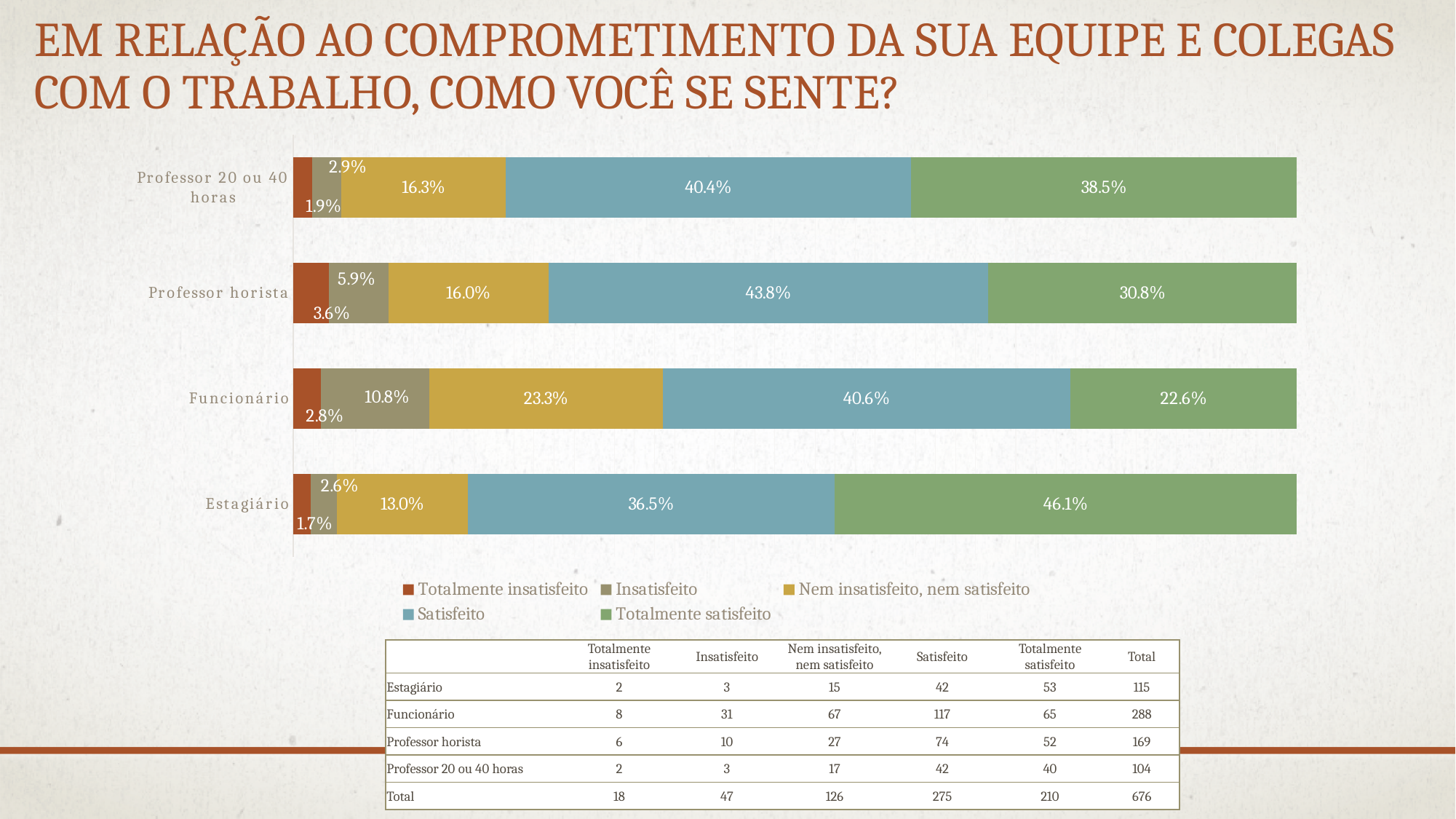
What is the value for Insatisfeito in the Funcionário bar? 10.8% Which category has the highest Insatisfeito share? Funcionário What is the value for Satisfeito in the Professor horista bar? 43.8% Which is larger, the Nem insatisfeito, nem satisfeito value for Funcionário or for Professor horista? Funcionário What is the difference between the Satisfeito values for Professor horista and Professor 20 ou 40 horas? 3.4 percentage points What is the value for Totalmente satisfeito in the Estagiário bar? 46.1% Which category has the highest Totalmente satisfeito share? Estagiário Which colour represents Satisfeito in the legend? Blue What kind of chart is shown on the slide? Stacked bar chart How many categories are shown on the chart? 4 Which category has the lowest Totalmente insatisfeito share? Estagiário How many series does the legend list? 5